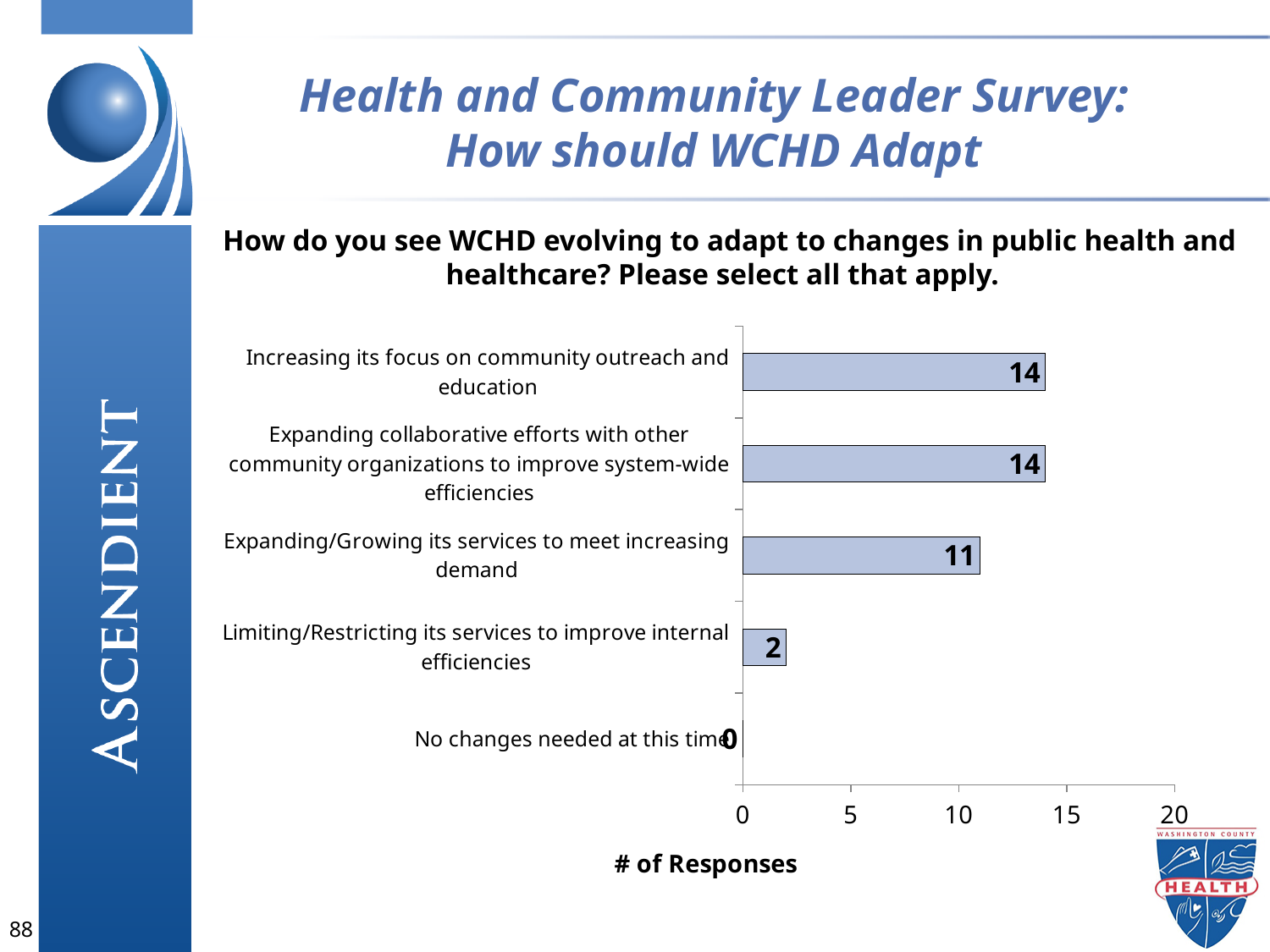
How many responses were given for "Expanding/Growing its services to meet increasing demand"? 11 Is the value for "Expanding/Growing its services to meet increasing demand" greater or less than 10? greater How many responses were given for "Increasing its focus on community outreach and education"? 14 What is the difference in responses between "Expanding/Growing its services to meet increasing demand" and "Limiting/Restricting its services to improve internal efficiencies"? 9 How many categories are shown in the chart? 5 What kind of chart is shown on the slide? Bar chart Which has more responses: "Expanding/Growing its services to meet increasing demand" or "Limiting/Restricting its services to improve internal efficiencies"? Expanding/Growing its services to meet increasing demand Which category has the fewest responses? No changes needed at this time What is the difference in responses between "Increasing its focus on community outreach and education" and "Expanding/Growing its services to meet increasing demand"? 3 How many responses were given for "Limiting/Restricting its services to improve internal efficiencies"? 2 What is the label of the horizontal axis? # of Responses How many responses were given for "No changes needed at this time"? 0